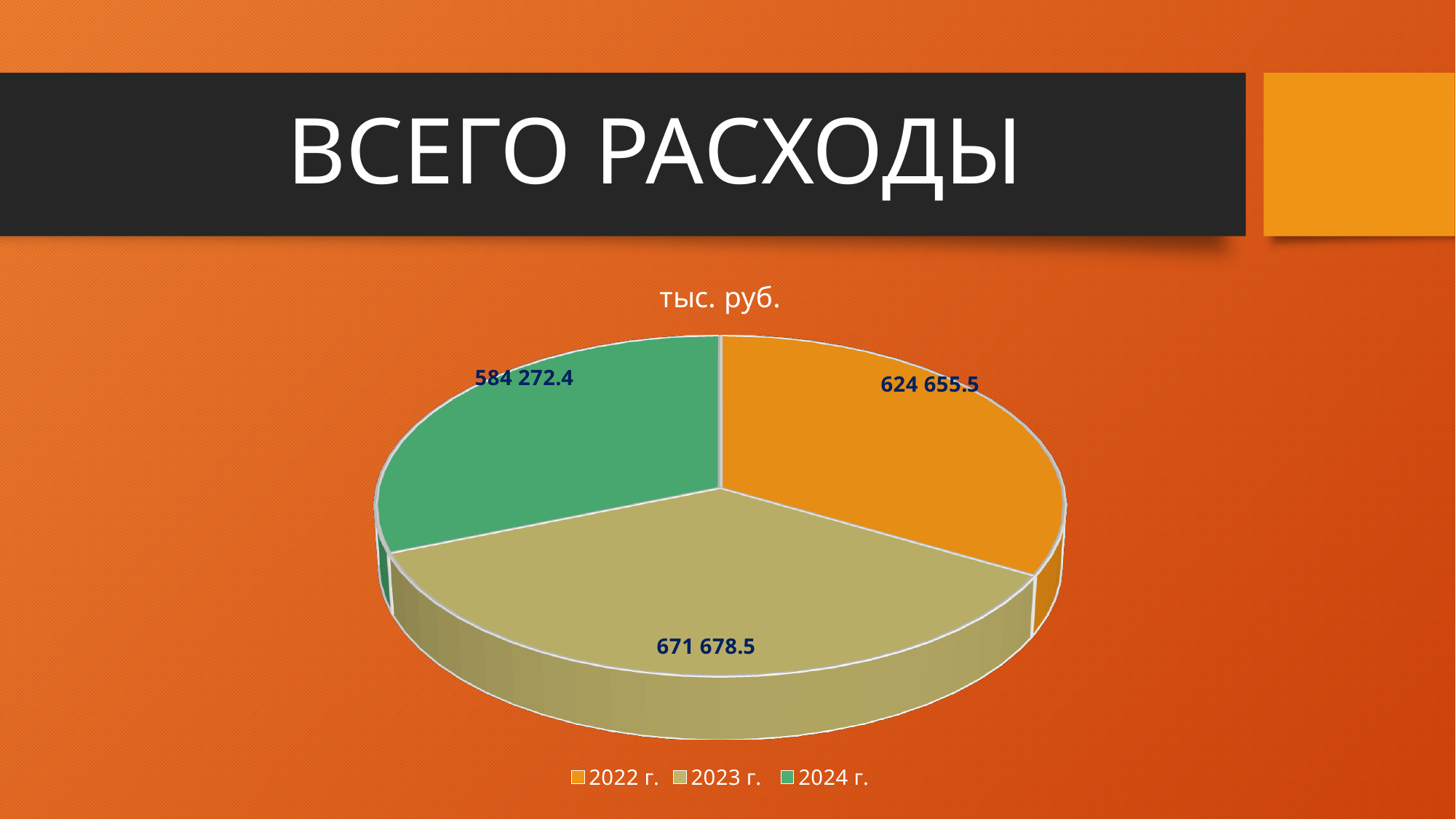
What kind of chart is shown on the slide? Pie chart Which year has the largest slice in the pie chart? 2023 г. Which is larger, the value for 2022 г. or the value for 2024 г.? 2022 г. What is the value for 2023 г. in the pie chart? 671 678.5 What is the value for 2022 г. in the pie chart? 624 655.5 Which colour represents 2024 г. in the pie chart? Green Which year has the smallest slice in the pie chart? 2024 г. How many slices does the pie chart have? 3 What is the difference between the values for 2023 г. and 2022 г.? 47 023.0 What is the title of the chart? тыс. руб. What is the value for 2024 г. in the pie chart? 584 272.4 What is the difference between the values for 2022 г. and 2024 г.? 40 383.1